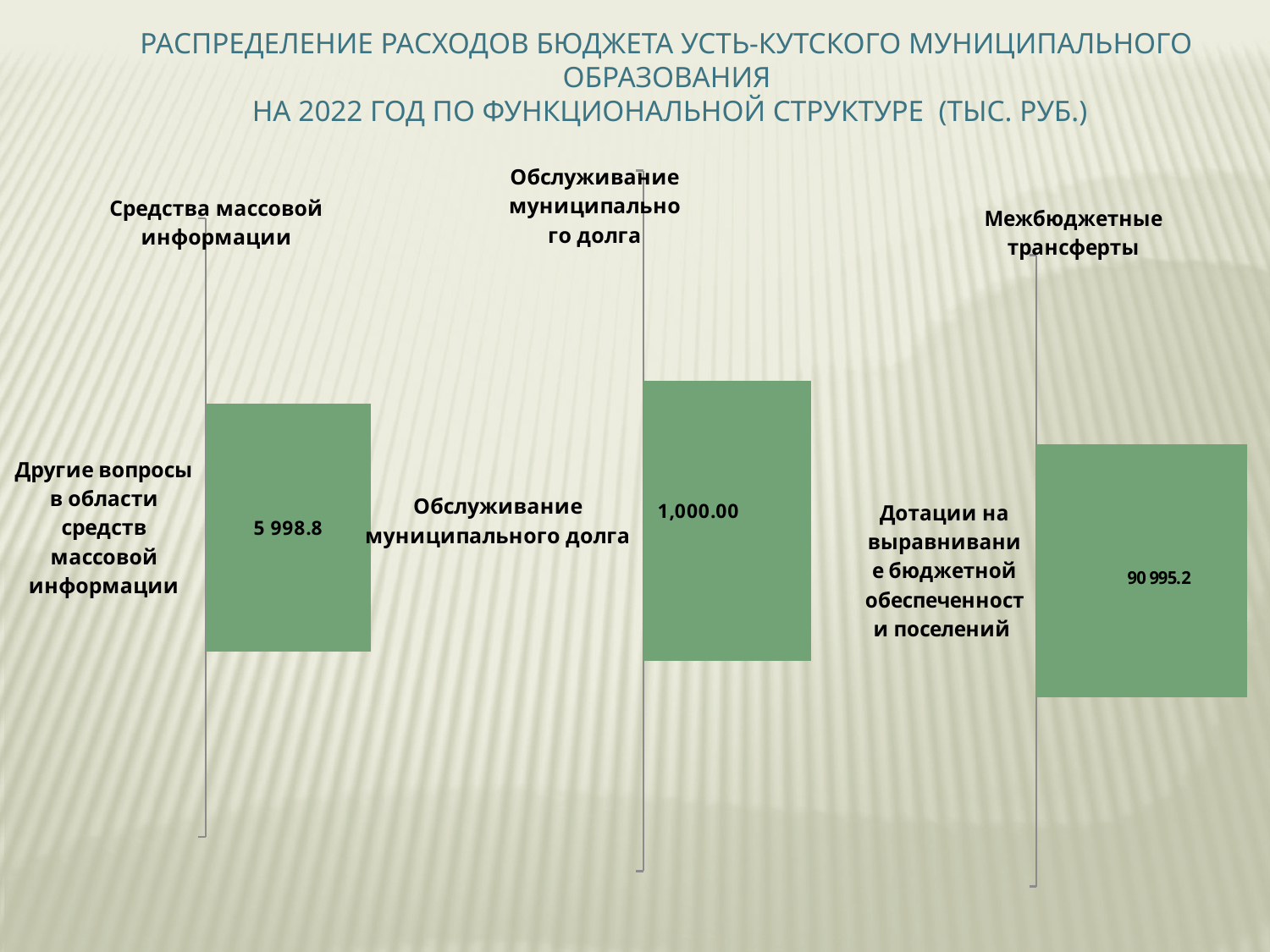
Across the three charts on the slide, which chart shows the lowest value? Обслуживание муниципального долга What is the difference between the value in the chart titled "Средства массовой информации" and the value in the chart titled "Обслуживание муниципального долга"? 4 998.8 Which is larger: the value in the chart titled "Средства массовой информации" or the value in the chart titled "Обслуживание муниципального долга"? Средства массовой информации In the chart titled "Средства массовой информации", what is the value for "Другие вопросы в области средств массовой информации"? 5 998.8 In the chart titled "Межбюджетные трансферты", what is the value for "Дотации на выравнивание бюджетной обеспеченности поселений"? 90 995.2 Across the three charts on the slide, which chart shows the highest value? Межбюджетные трансферты How many bars are plotted in the chart titled "Средства массовой информации"? 1 In the chart titled "Обслуживание муниципального долга", what is the value for "Обслуживание муниципального долга"? 1,000.00 How many separate charts are shown on the slide? 3 What kind of chart is the chart titled "Межбюджетные трансферты"? bar chart What is the title of the chart on the right side of the slide? Межбюджетные трансферты What is the difference between the value in the chart titled "Межбюджетные трансферты" and the value in the chart titled "Средства массовой информации"? 84 996.4